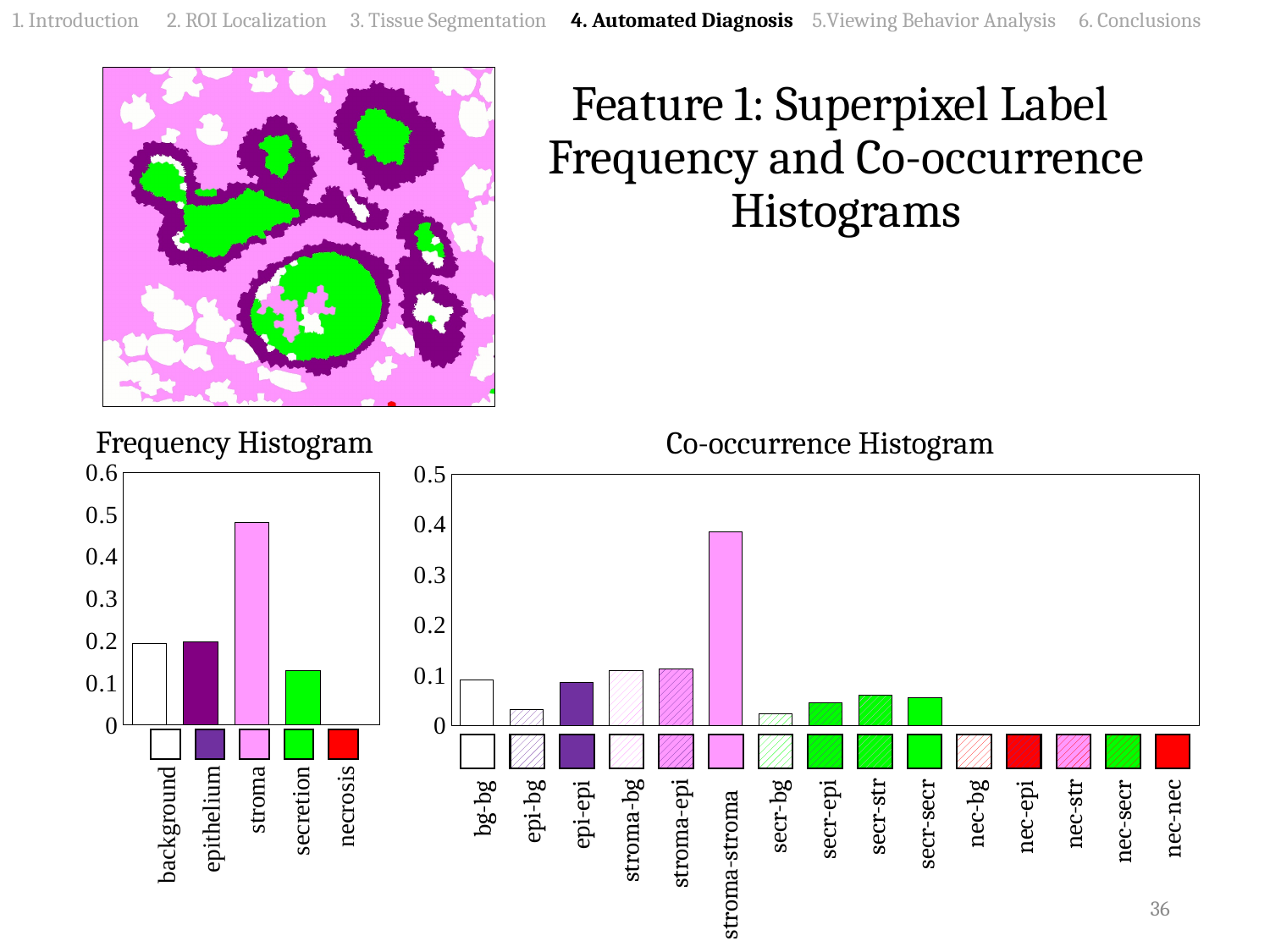
In the Co-occurrence Histogram, is the value for stroma-stroma greater or less than 0.3? greater In the Co-occurrence Histogram, how many categories are shown on the x axis? 15 In the Co-occurrence Histogram, which category has the highest value? stroma-stroma What kind of chart is the Co-occurrence Histogram? bar chart In the Co-occurrence Histogram, which is larger, the value for epi-epi or the value for epi-bg? epi-epi In the Frequency Histogram, is the value for secretion greater or less than 0.2? less In the Frequency Histogram, which is larger, the value for stroma or the value for secretion? stroma In the Frequency Histogram, which category has the lowest value? necrosis In the Co-occurrence Histogram, is the value for epi-bg greater or less than 0.1? less In the Frequency Histogram, how many categories are shown on the x axis? 5 In the Frequency Histogram, which category has the highest value? stroma